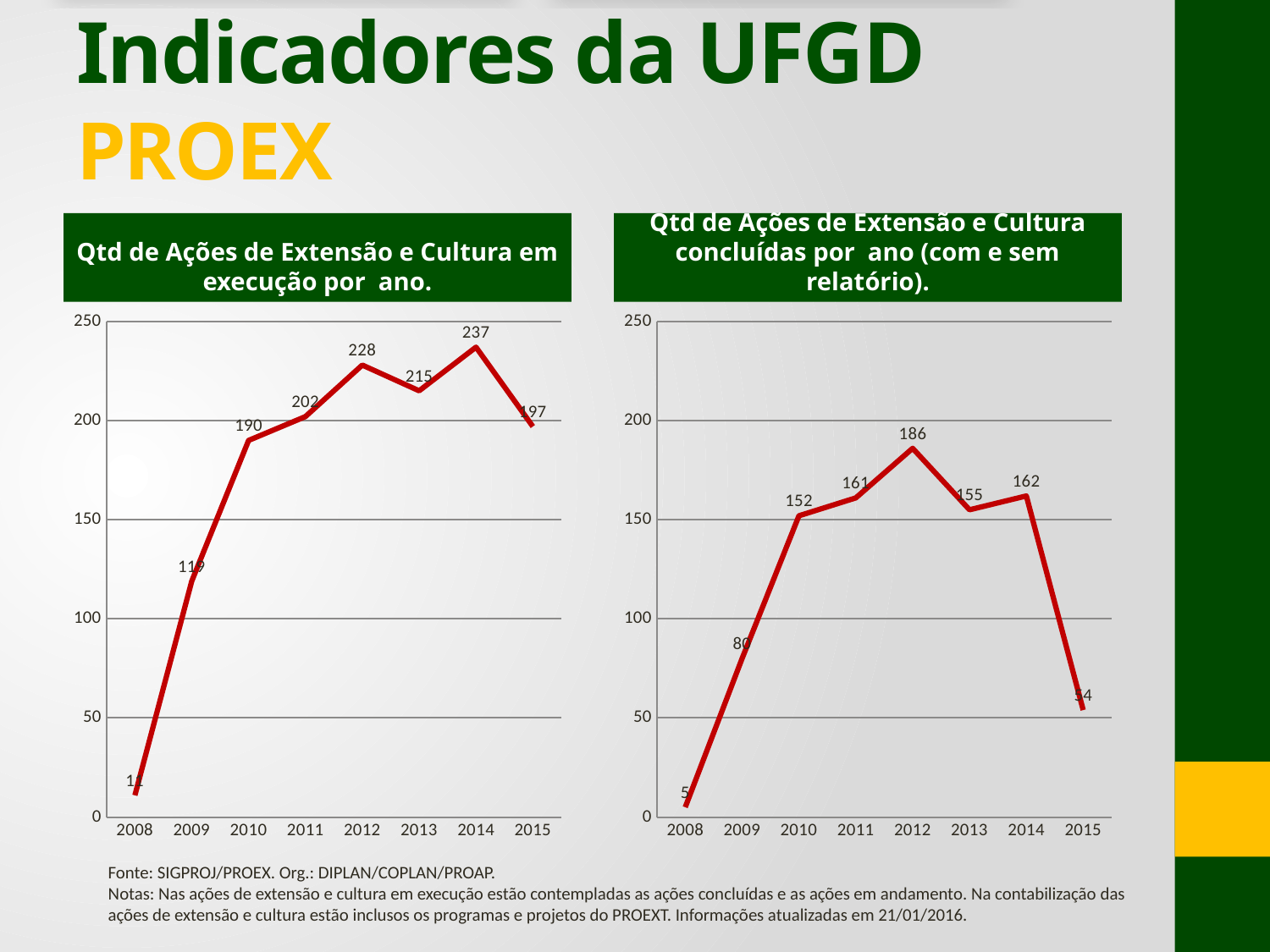
In the left chart (Qtd de Ações de Extensão e Cultura em execução por ano), which year has the highest value? 2014 In the right chart (Qtd de Ações de Extensão e Cultura concluídas por ano), which year has the lowest value? 2008 In the left chart (Qtd de Ações de Extensão e Cultura em execução por ano), is the value for 2009 greater or less than 150? less In the right chart (Qtd de Ações de Extensão e Cultura concluídas por ano), which year has the highest value? 2012 In the left chart (Qtd de Ações de Extensão e Cultura em execução por ano), what is the difference between the values for 2014 and 2015? 40 How many years are plotted in the left chart (Qtd de Ações de Extensão e Cultura em execução por ano)? 8 In the right chart (Qtd de Ações de Extensão e Cultura concluídas por ano), what is the difference between the values for 2012 and 2013? 31 In the left chart (Qtd de Ações de Extensão e Cultura em execução por ano), what is the value for 2012? 228 In the right chart (Qtd de Ações de Extensão e Cultura concluídas por ano), is the value for 2015 greater or less than 100? less In the right chart (Qtd de Ações de Extensão e Cultura concluídas por ano), what is the value for 2012? 186 What kind of chart is the left chart (Qtd de Ações de Extensão e Cultura em execução por ano)? line chart In the left chart (Qtd de Ações de Extensão e Cultura em execução por ano), what is the value for 2014? 237